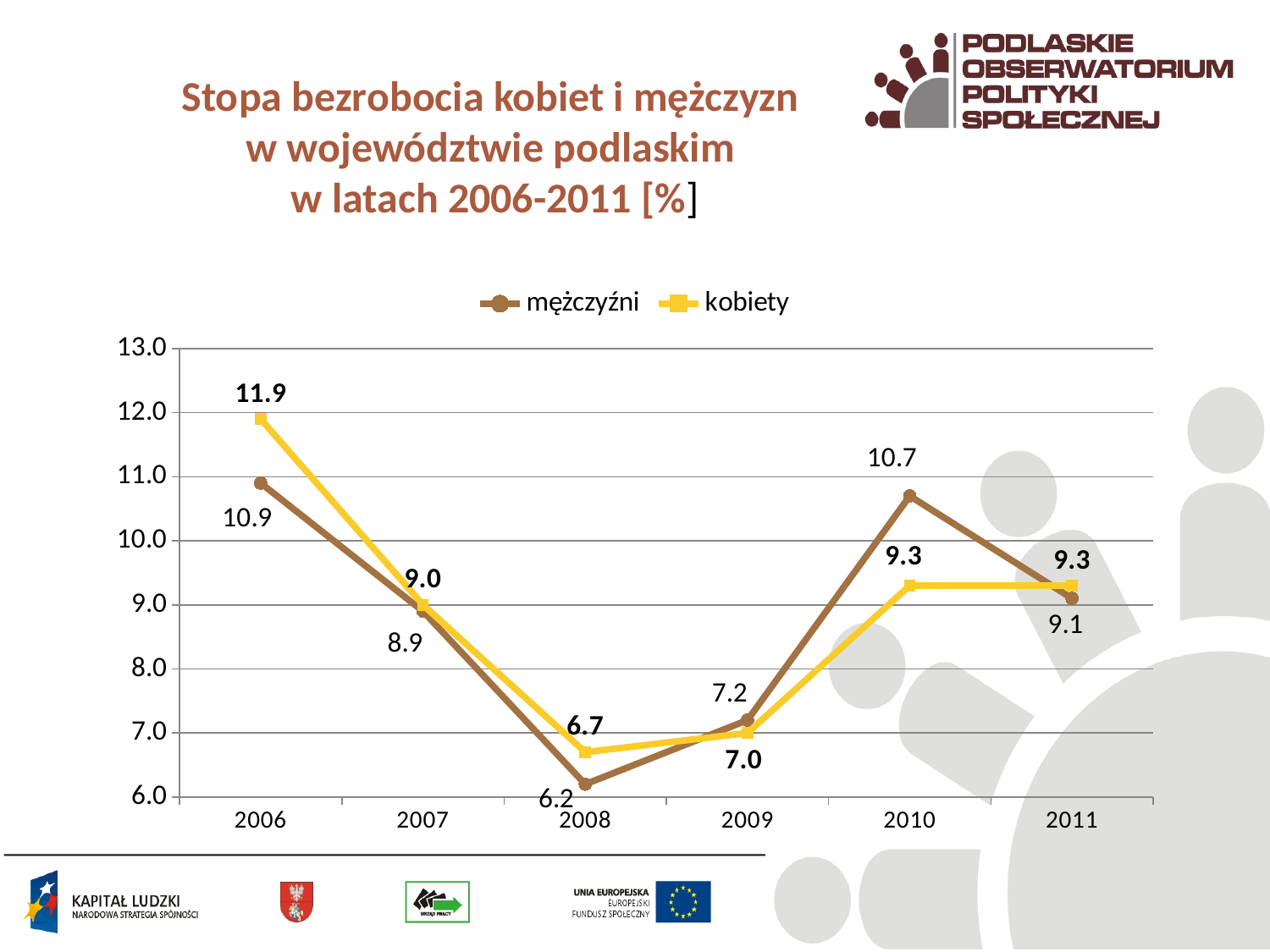
What kind of chart is shown on the slide? line chart What is the value for mężczyźni in 2010? 10.7 What is the value for mężczyźni in 2011? 9.1 Which series has the higher value in 2010, mężczyźni or kobiety? mężczyźni What is the difference between the kobiety and mężczyźni values in 2006? 1.0 In which year is the value for kobiety the highest? 2006 Does the value for mężczyźni rise or fall from 2006 to 2008? fall How many years are shown on the x axis? 6 How many series does the legend list? 2 What is the value for kobiety in 2008? 6.7 What is the value for kobiety in 2006? 11.9 In which year is the value for mężczyźni the lowest? 2008